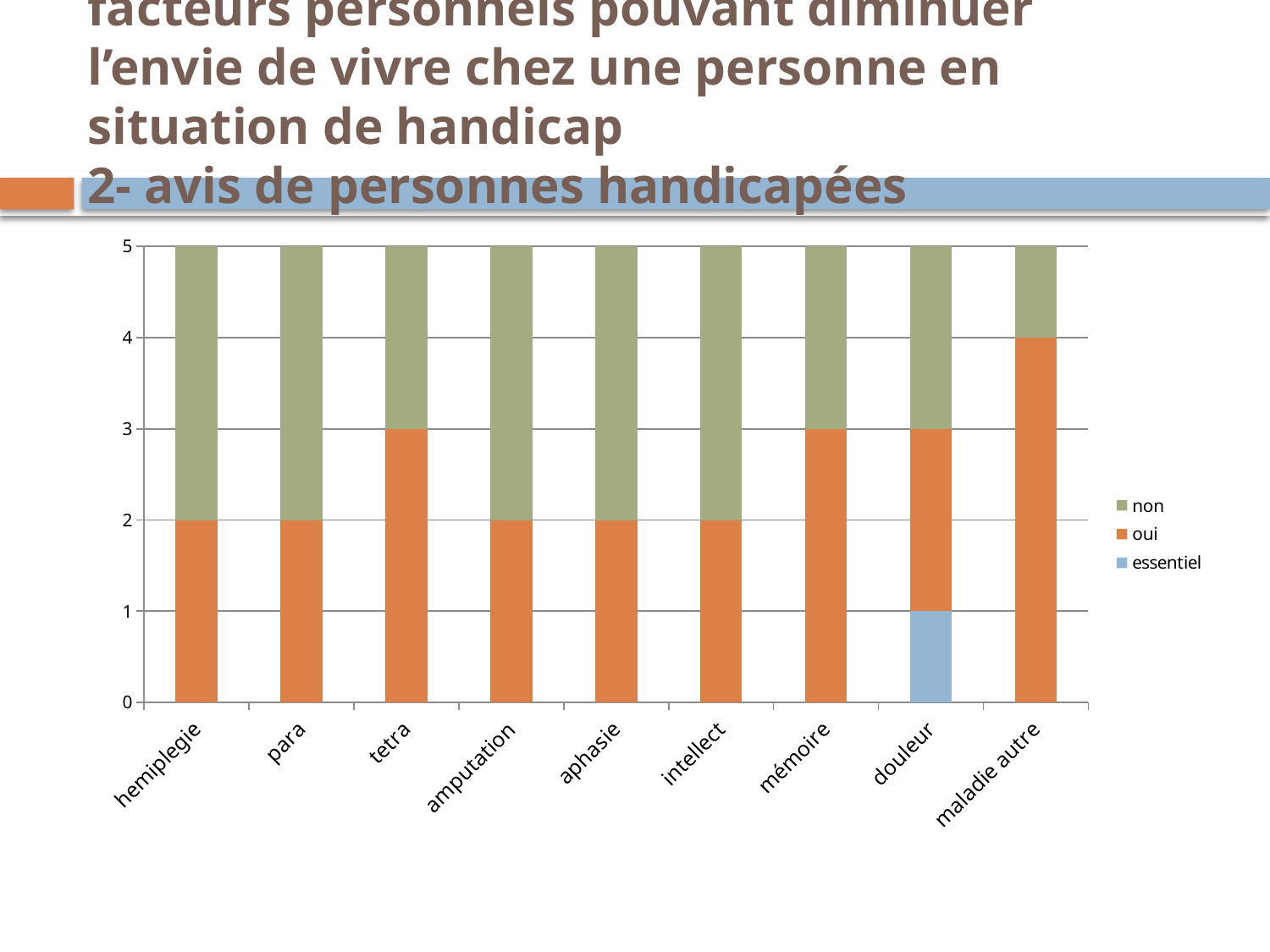
Is the "oui" value for maladie autre greater or less than 3? greater Which is larger, the "oui" value for tetra or the "oui" value for para? tetra What is the value of "oui" for tetra? 3 What is the value of "essentiel" for douleur? 1 How many series does the chart legend list? 3 Which category has the highest value for "oui"? maladie autre What are the series names listed in the chart legend? non, oui, essentiel What is the total height of the stacked bar for douleur? 5 What kind of chart is shown on the slide? stacked bar chart What is the value of "oui" for hemiplegie? 2 How many categories are shown on the x axis of the chart? 9 What is the value of "oui" for maladie autre? 4